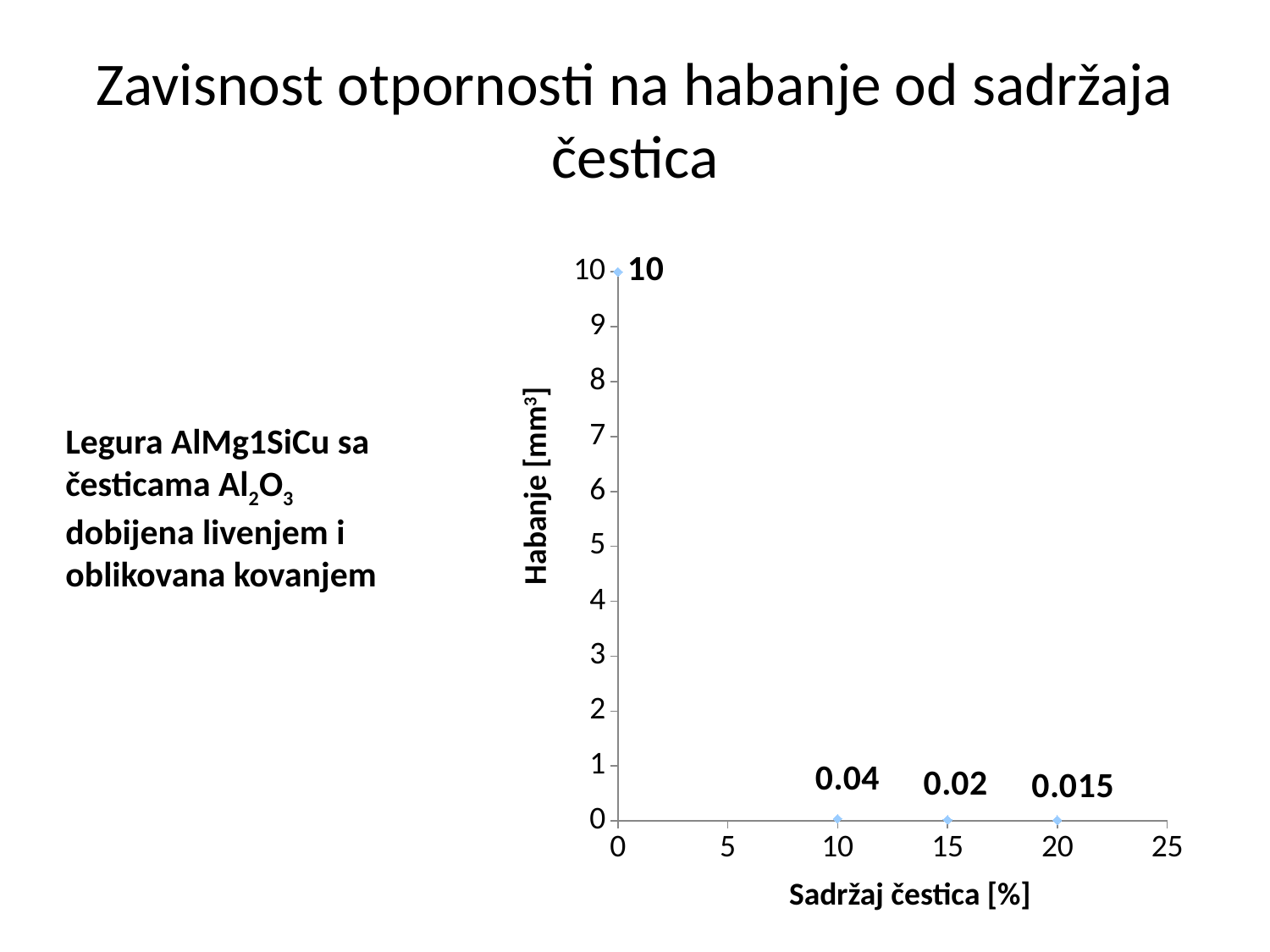
At which particle content is the wear highest? 0% At which particle content is the wear lowest? 20% What is the wear value at a particle content of 15%? 0.02 What is the wear value at a particle content of 20%? 0.015 What is the wear (Habanje) value at a particle content of 0%? 10 Does the wear rise or fall as the particle content increases along the x axis? fall How many data points are plotted on the chart? 4 Which is larger, the wear at 15% or at 20% particle content? 15% What is the wear value at a particle content of 10%? 0.04 What is the difference between the wear at 0% and the wear at 10% particle content? 9.96 What kind of chart is shown on the slide? scatter chart What is the difference between the wear at 10% and the wear at 15% particle content? 0.02